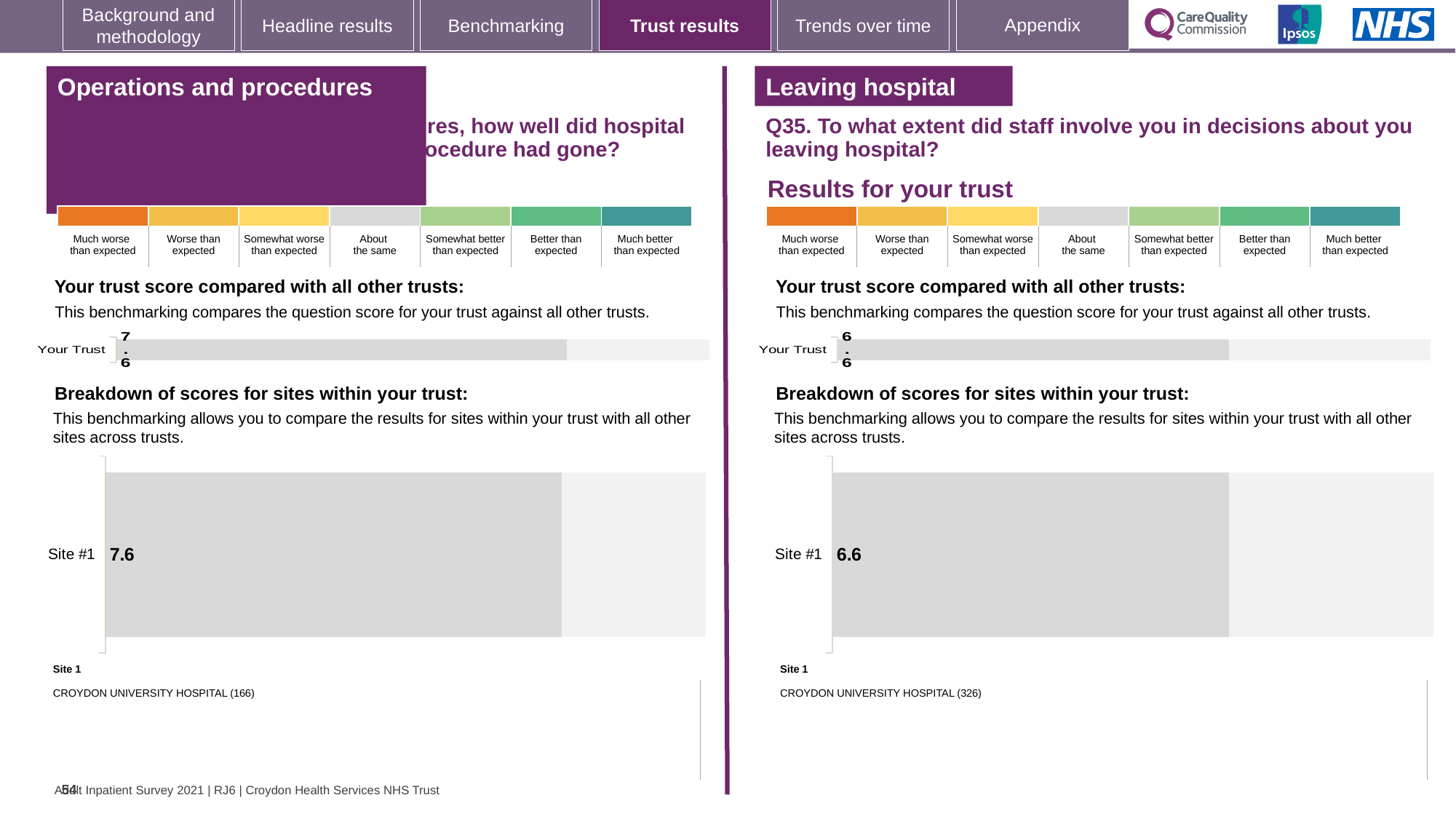
Which site is labelled as Site 1 beneath the breakdown chart in the 'Leaving hospital' section? CROYDON UNIVERSITY HOSPITAL (326) On the 'Operations and procedures' section, what is the score shown for Site #1 in the breakdown of scores for sites chart? 7.6 On the 'Leaving hospital' section, what is the score shown for Site #1 in the breakdown of scores for sites chart? 6.6 What type of chart is used to show the Site #1 score in the 'Leaving hospital' section? Bar chart Which site is labelled as Site 1 beneath the breakdown chart in the 'Operations and procedures' section? CROYDON UNIVERSITY HOSPITAL (166) How many sites are shown in the 'Breakdown of scores for sites within your trust' chart on the 'Leaving hospital' section? 1 How many sites are shown in the 'Breakdown of scores for sites within your trust' chart on the 'Operations and procedures' section? 1 On the 'Operations and procedures' section, what is the 'Your Trust' score in the trust score comparison chart? 7.6 Which Site #1 score is larger: the one in the 'Operations and procedures' breakdown chart or the one in the 'Leaving hospital' breakdown chart? Operations and procedures What is the difference between the Site #1 score in the 'Operations and procedures' breakdown chart and the Site #1 score in the 'Leaving hospital' breakdown chart? 1.0 On the 'Leaving hospital' section, what is the 'Your Trust' score in the trust score comparison chart? 6.6